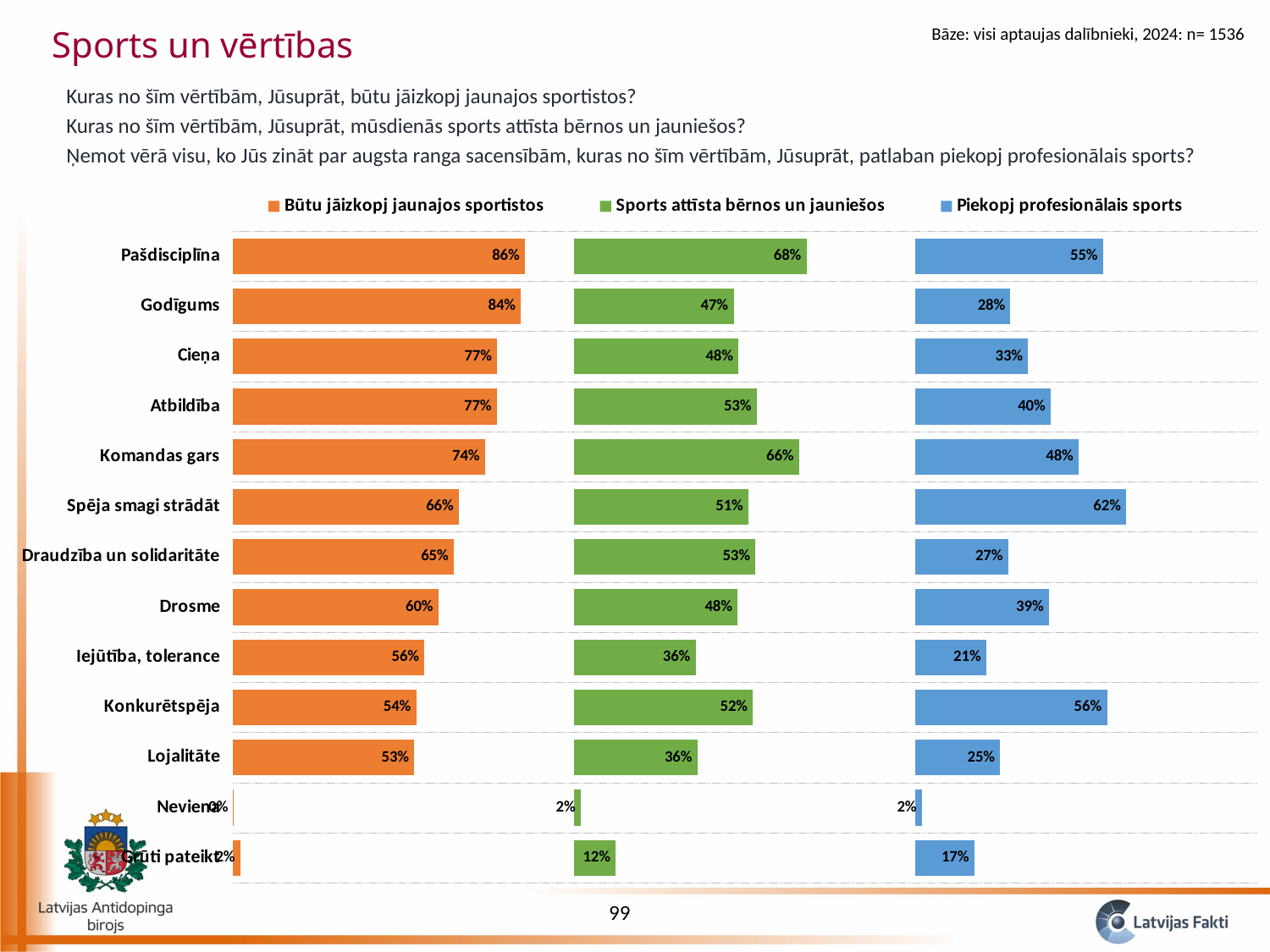
What is the value for Pašdisciplīna in the 'Būtu jāizkopj jaunajos sportistos' series? 86% What is the value for Komandas gars in the 'Sports attīsta bērnos un jauniešos' series? 66% For Konkurētspēja, which is larger: the 'Būtu jāizkopj jaunajos sportistos' value or the 'Piekopj profesionālais sports' value? Piekopj profesionālais sports Which category has the highest value in the 'Piekopj profesionālais sports' series? Spēja smagi strādāt How many series does the legend list? 3 What is the difference between the 'Būtu jāizkopj jaunajos sportistos' and 'Piekopj profesionālais sports' values for Godīgums? 56 percentage points What kind of chart is shown on the slide? Bar chart What is the value for Spēja smagi strādāt in the 'Piekopj profesionālais sports' series? 62% Which category has the highest value in the 'Būtu jāizkopj jaunajos sportistos' series? Pašdisciplīna Among the named values, which category has the lowest value in the 'Sports attīsta bērnos un jauniešos' series (excluding the 'none' and 'hard to say' rows)? Iejūtība, tolerance and Lojalitāte (both 36%) What is the value for Drosme in the 'Piekopj profesionālais sports' series? 39% What colour are the bars for the 'Sports attīsta bērnos un jauniešos' series? Green